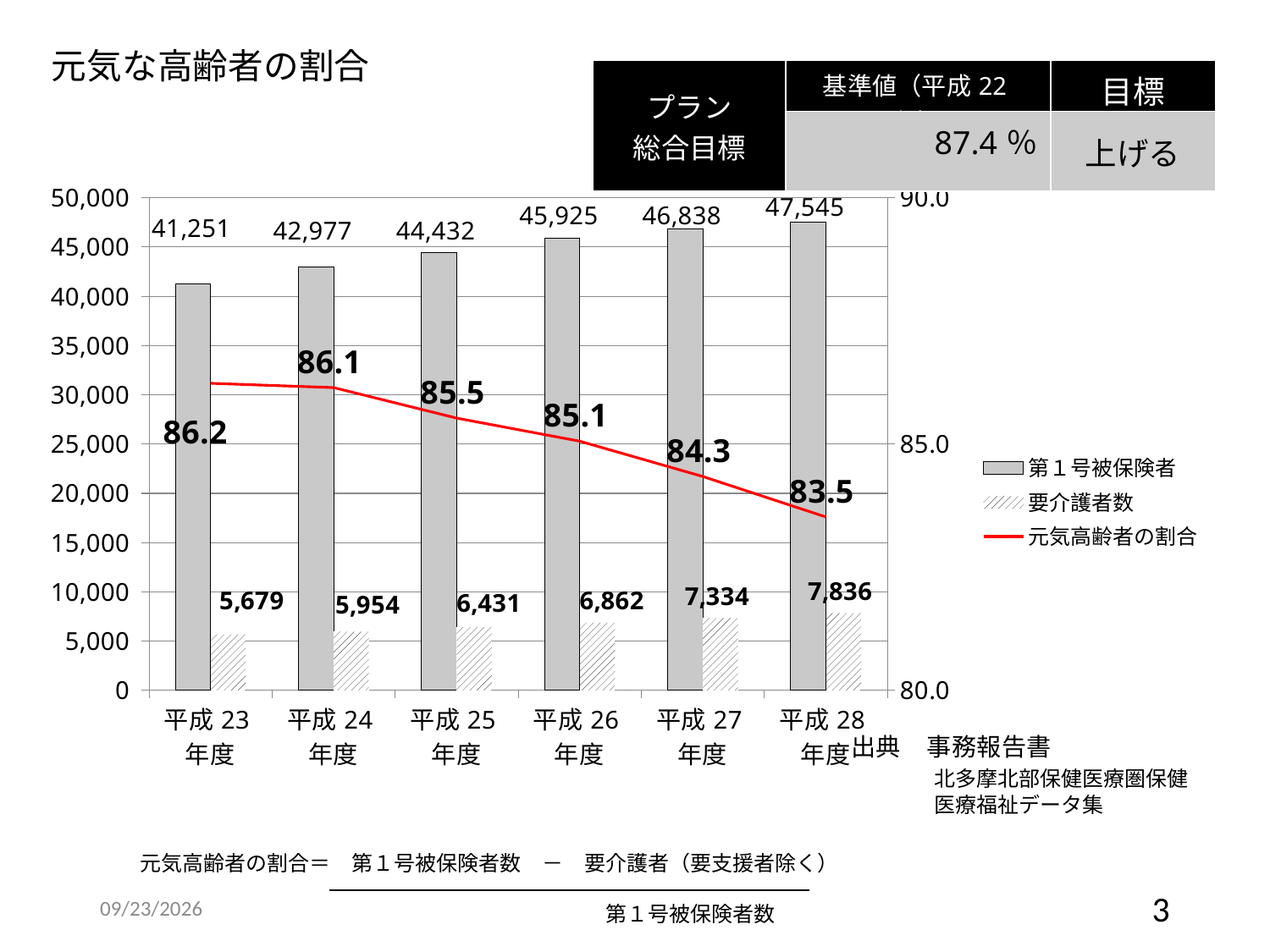
Which is larger, the 要介護者数 value for 平成 26 年度 or for 平成 25 年度? 平成 26 年度 What is the difference between the 要介護者数 values for 平成 24 年度 and 平成 23 年度? 275 What colour is the 元気高齢者の割合 line? red How many years are shown on the x axis? 6 What is the value of 第１号被保険者 for 平成 25 年度? 44,432 Does the 元気高齢者の割合 line rise or fall from 平成 23 年度 to 平成 28 年度? fall How many series does the legend list? 3 Which year has the highest 第１号被保険者 value? 平成 28 年度 What is the 元気高齢者の割合 value for 平成 26 年度? 85.1 What is the value of 要介護者数 for 平成 27 年度? 7,334 Which year has the lowest 元気高齢者の割合 value? 平成 28 年度 What is the difference between the 第１号被保険者 values for 平成 28 年度 and 平成 23 年度? 6,294